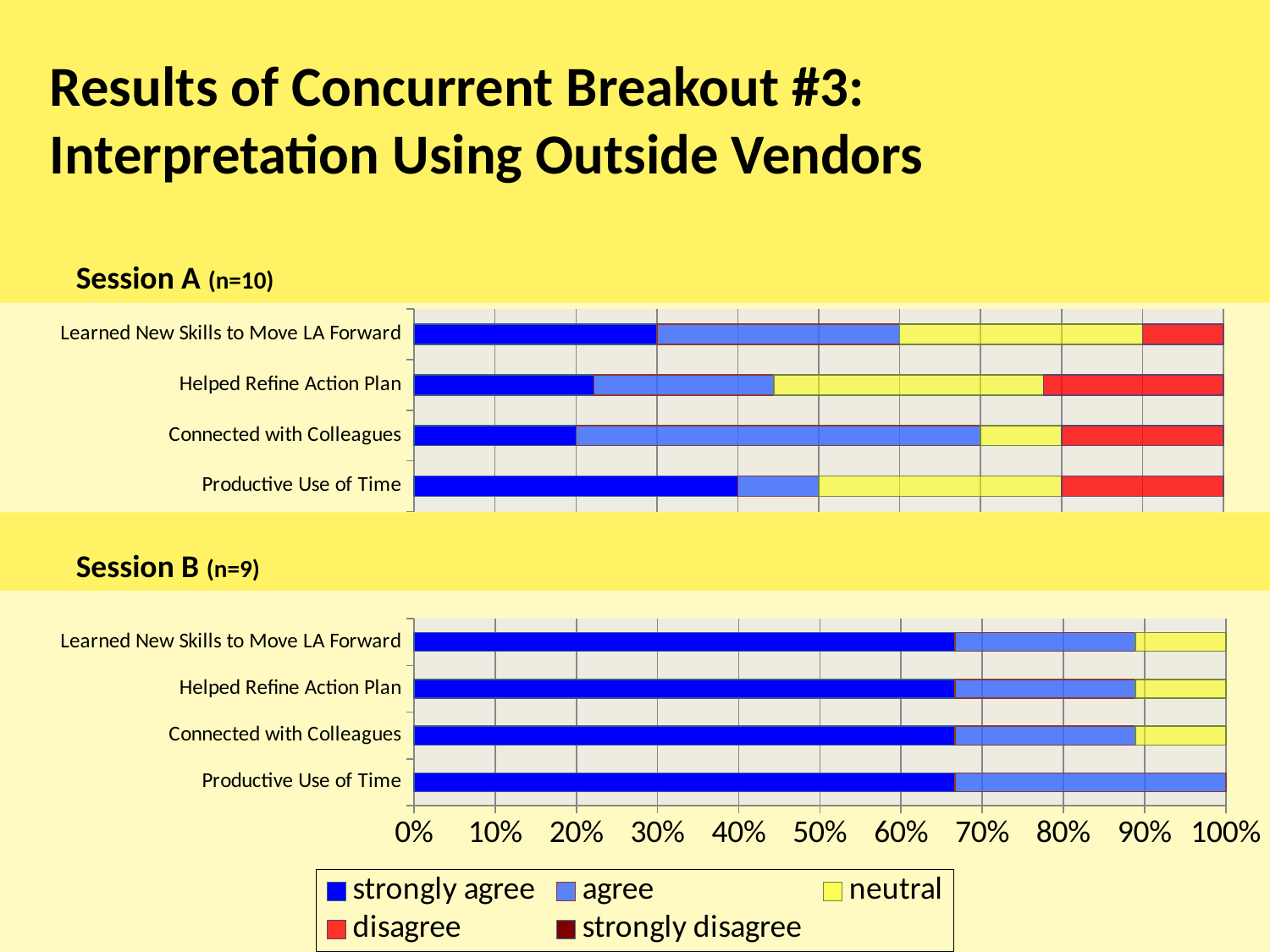
How many categories are shown in the Session B (n=9) chart? 4 How many series does the legend list? 5 In the Session B (n=9) chart, which category has no neutral segment? Productive Use of Time In the Session A (n=10) chart, which category has the largest strongly agree share? Productive Use of Time In the Session A (n=10) chart, is the strongly agree value for Helped Refine Action Plan greater or less than 30%? less What kind of chart is used for Session A (n=10)? stacked bar chart In the Session A (n=10) chart, what is the strongly agree value for Productive Use of Time? 40% What sample size is given for Session B? n=9 In the Session A (n=10) chart, which has the larger strongly agree share: Productive Use of Time or Connected with Colleagues? Productive Use of Time In the Session B (n=9) chart, is the strongly agree value for Productive Use of Time greater or less than 60%? greater What colour represents neutral in the legend? yellow In the Session A (n=10) chart, what is the strongly agree value for Learned New Skills to Move LA Forward? 30%